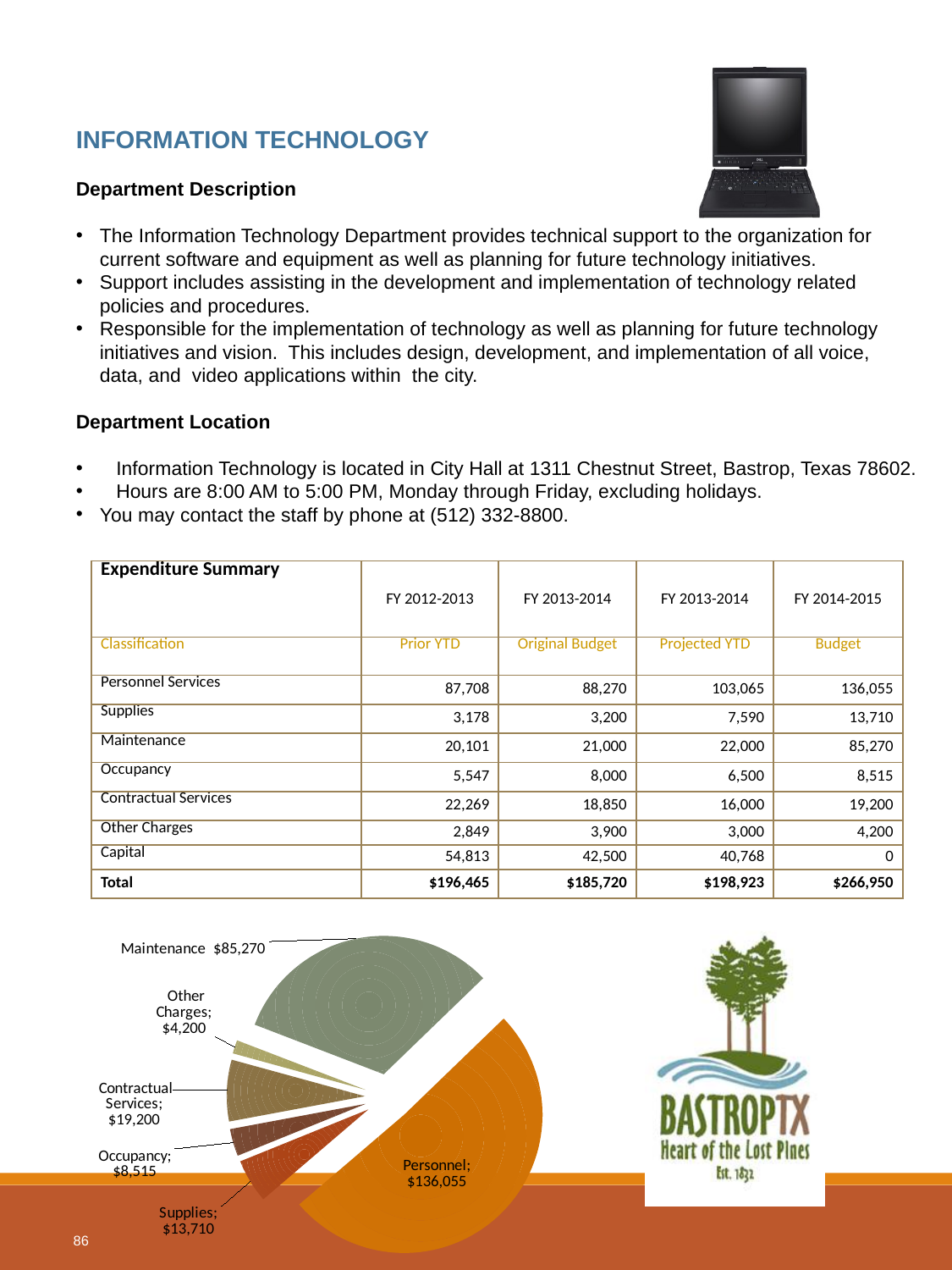
Which category has the smallest slice in the pie chart? Other Charges In the pie chart, which is larger: Contractual Services or Supplies? Contractual Services Which category has the largest slice in the pie chart? Personnel What is the value shown for Supplies in the pie chart? $13,710 What colour is the Personnel slice in the pie chart? Orange In the pie chart, what is the difference between Contractual Services and Occupancy? $10,685 How many slices does the pie chart have? 6 What is the value shown for Personnel in the pie chart? $136,055 In the pie chart, how much larger is Personnel than Maintenance? $50,785 What is the value shown for Occupancy in the pie chart? $8,515 What is the value shown for Maintenance in the pie chart? $85,270 What kind of chart is shown at the bottom left of the slide? Pie chart